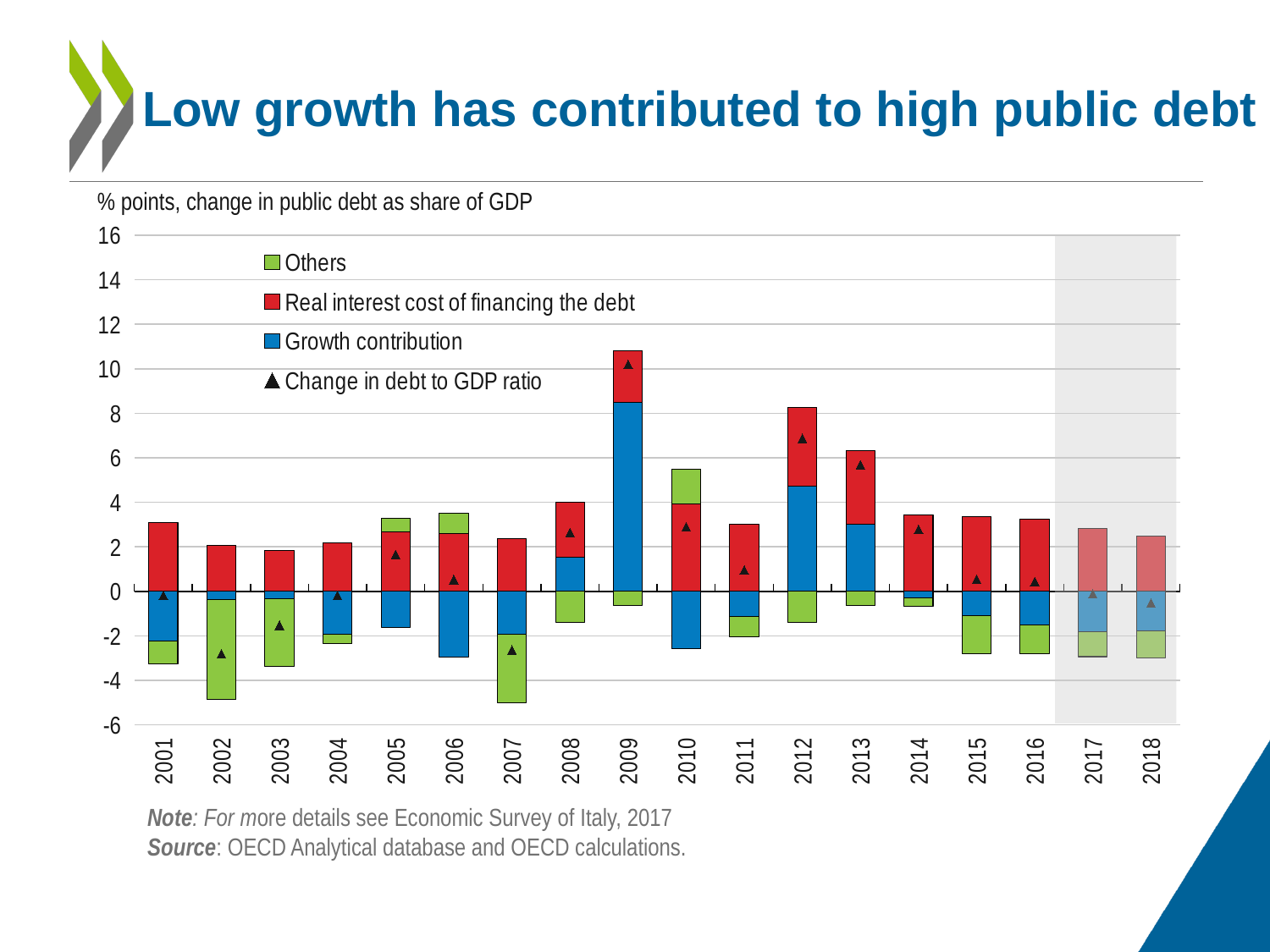
Is the lowest point of the stacked bar for 2007 greater or less than -4? less Is the growth contribution for 2009 greater or less than 6? greater What kind of chart is shown on the slide? bar chart In which year is the change in debt to GDP ratio (triangle marker) highest? 2009 Which year has the larger change in debt to GDP ratio, 2012 or 2013? 2012 How many series does the chart's legend list? 4 Which years on the chart are shown with a shaded background? 2017 and 2018 Is the change in debt to GDP ratio for 2009 greater or less than 8? greater How many years are shown along the x axis of the chart? 18 Does the change in debt to GDP ratio rise or fall from 2012 to 2016? fall Which year has the larger growth contribution, 2009 or 2012? 2009